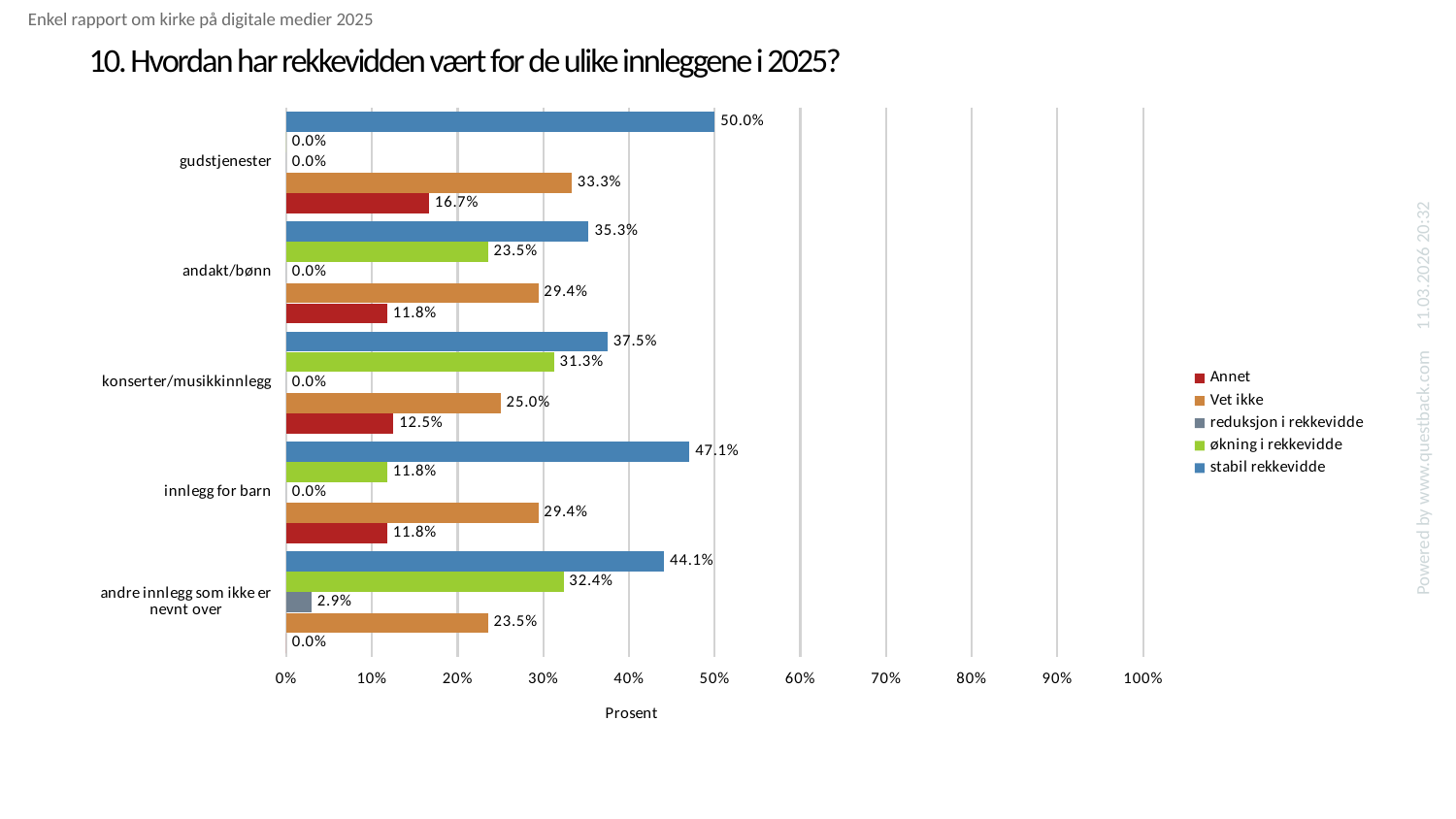
What is the value for 'økning i rekkevidde' for konserter/musikkinnlegg? 31.3% What is the difference between 'stabil rekkevidde' and 'Vet ikke' for innlegg for barn? 17.7% Which category has the lowest value for 'stabil rekkevidde'? andakt/bønn How many series does the legend list? 5 How many categories are shown on the y axis? 5 Which category has the highest value for 'stabil rekkevidde'? gudstjenester What is the value for 'reduksjon i rekkevidde' for 'andre innlegg som ikke er nevnt over'? 2.9% What is the value for 'Vet ikke' for andakt/bønn? 29.4% What kind of chart is shown on the slide? bar chart Which is larger for konserter/musikkinnlegg: 'stabil rekkevidde' or 'Vet ikke'? stabil rekkevidde What is the value for 'stabil rekkevidde' for gudstjenester? 50.0% What is the label of the x axis? Prosent